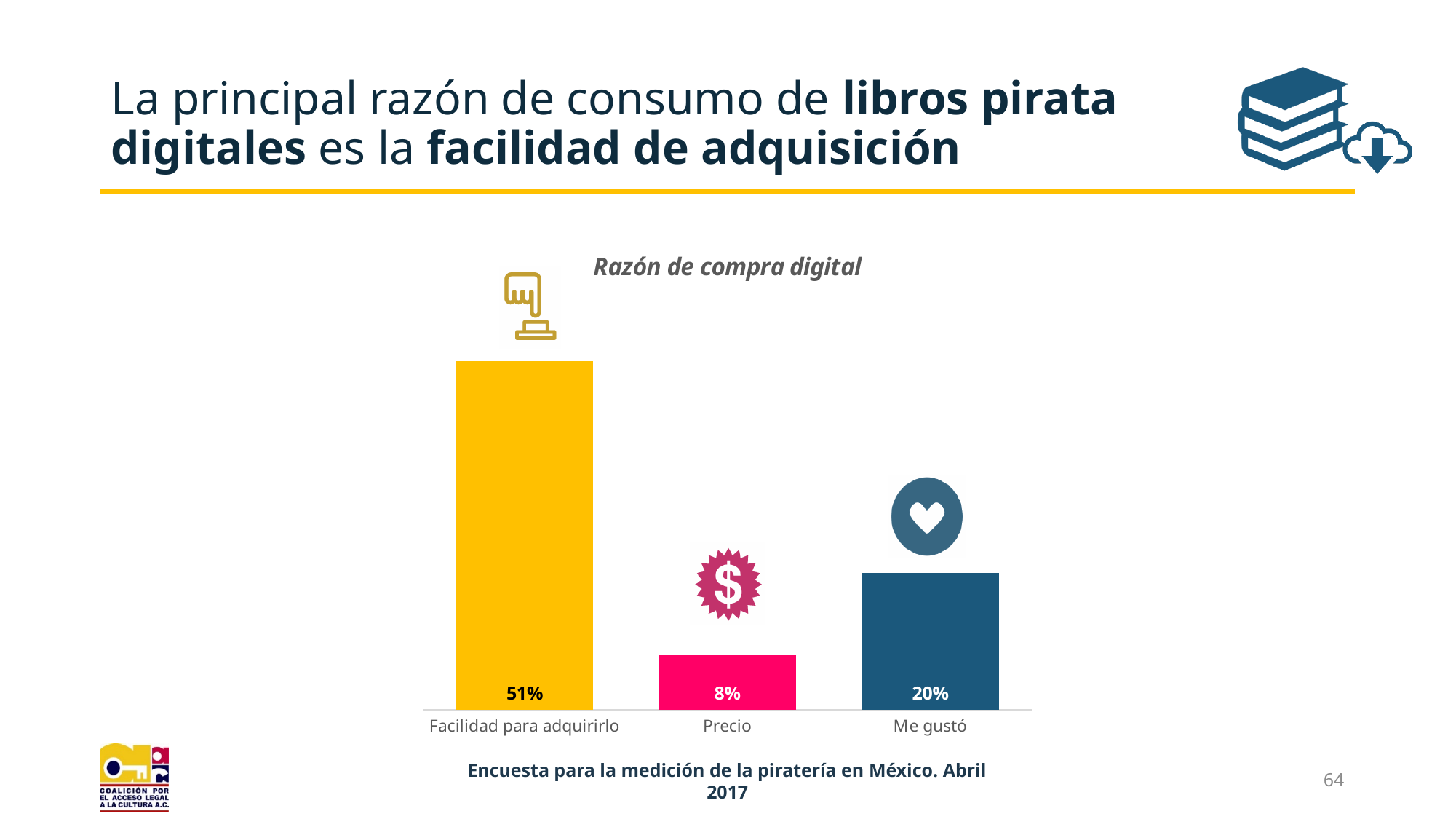
How many categories are shown in the chart? 3 Which category has the highest value? Facilidad para adquirirlo What is the difference between "Facilidad para adquirirlo" and "Me gustó"? 31% What kind of chart is shown on the slide? Bar chart What is the difference between "Me gustó" and "Precio"? 12% Which is larger, the value for "Precio" or the value for "Me gustó"? Me gustó What is the value for "Facilidad para adquirirlo"? 51% Which category has the lowest value? Precio What colour is the bar for "Precio"? Pink What is the value for "Precio"? 8% What is the title of the chart? Razón de compra digital What is the value for "Me gustó"? 20%